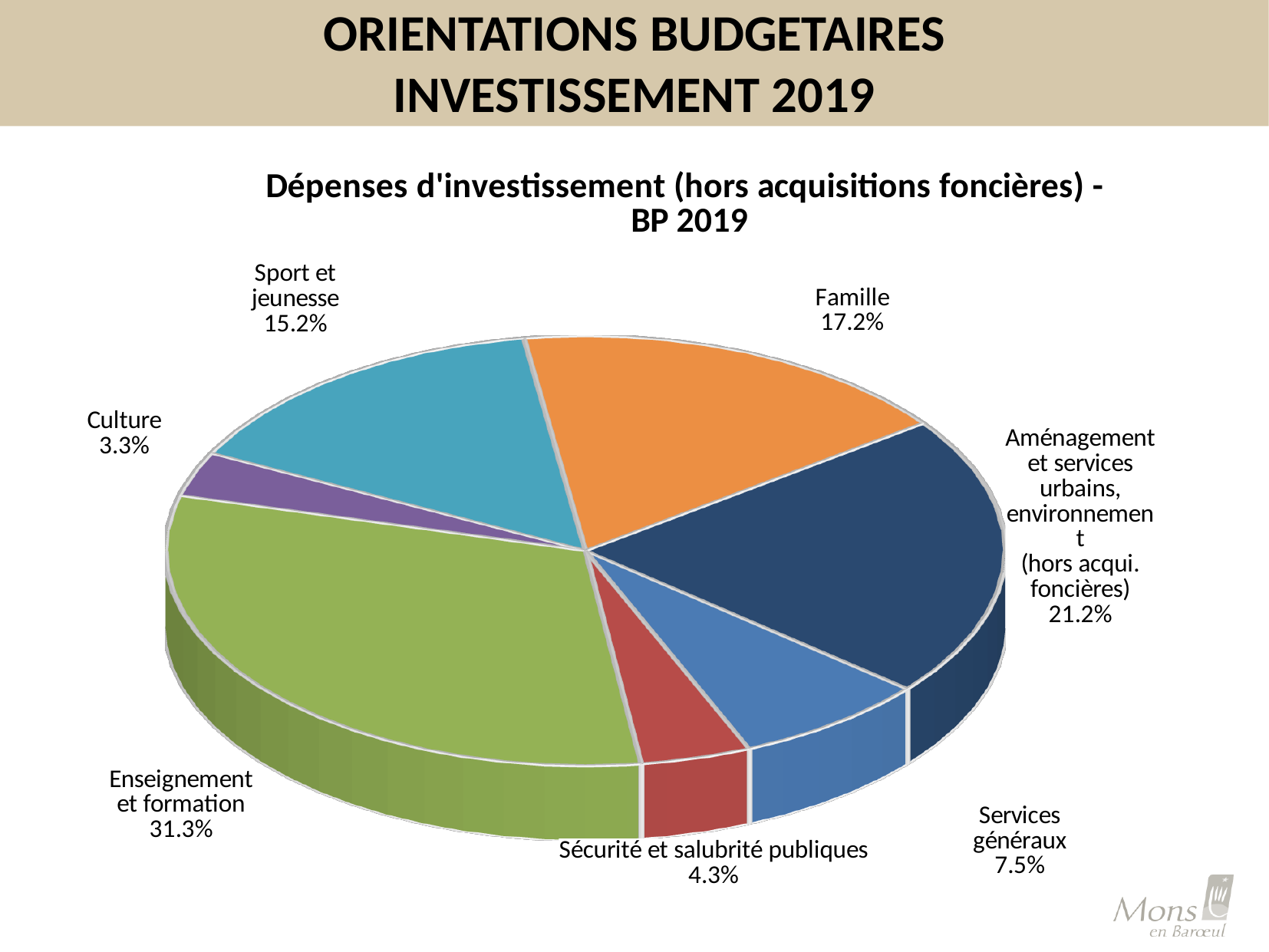
What kind of chart is shown on the slide? Pie chart What is the value shown for Aménagement et services urbains, environnement (hors acqui. foncières)? 21.2% Which category has the smallest slice of the pie? Culture What is the difference in percentage points between Famille and Sport et jeunesse? 2 percentage points Which category has the largest slice of the pie? Enseignement et formation How many categories are shown in the pie chart? 7 What is the value shown for Famille? 17.2% What colour is the slice for Culture? Purple What percentage is shown for Sport et jeunesse? 15.2% What is the title of the chart? Dépenses d'investissement (hors acquisitions foncières) - BP 2019 Which is larger, Services généraux or Sécurité et salubrité publiques? Services généraux What share of the pie does Enseignement et formation represent? 31.3%